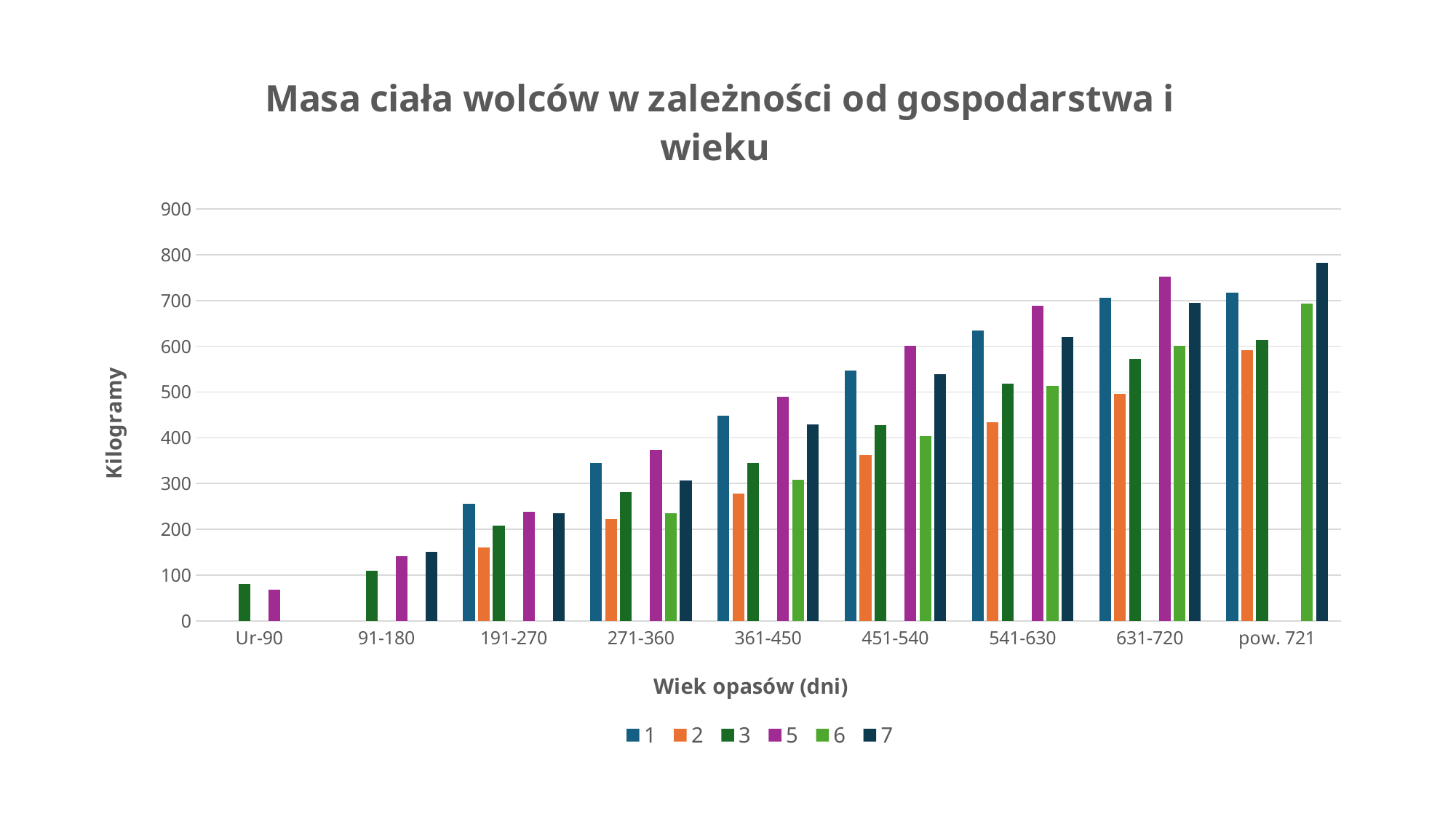
Do the values for series 1 rise or fall as the age categories increase along the x axis? rise Which series has the lowest value in the 191-270 category? 2 How many series does the legend list? 6 Is the value for series 2 in the 451-540 category greater or less than 400? less Is the value for series 7 in the pow. 721 category greater or less than 700? greater Is the value for series 5 in the 631-720 category greater or less than 700? greater How many bars are plotted for the Ur-90 category? 2 In the 451-540 category, which is larger: the value for series 1 or series 3? 1 What kind of chart is shown on the slide? bar chart Which series has the highest value in the 541-630 category? 5 How many age categories are shown on the x axis? 9 Which series has the highest value in the pow. 721 category? 7